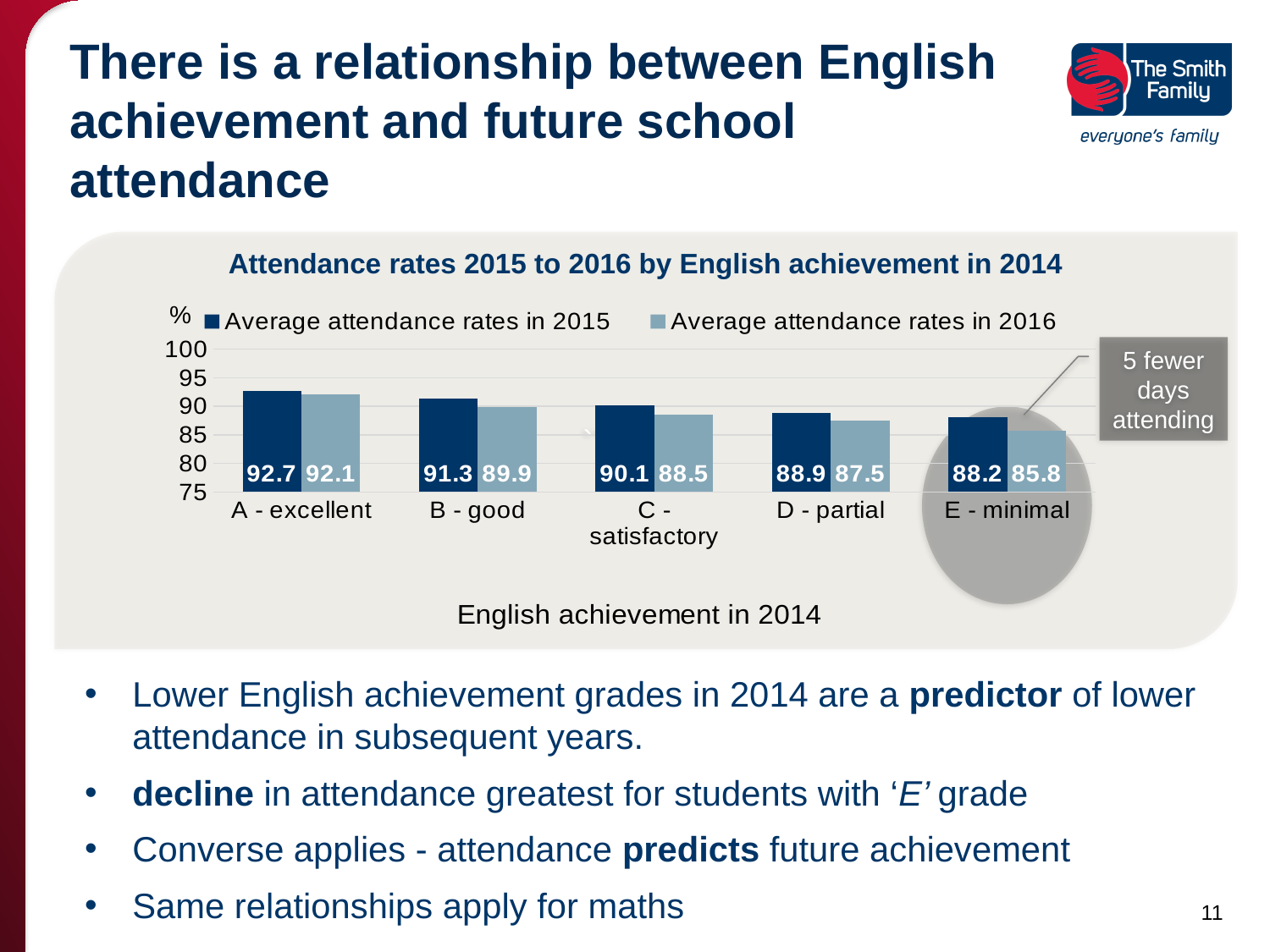
Do the average attendance rates in 2016 rise or fall moving from A - excellent to E - minimal? Fall Which English achievement category has the lowest average attendance rate in 2016? E - minimal What is the difference between the 2015 and 2016 average attendance rates for the E - minimal category? 2.4 What is the average attendance rate in 2016 for students with an E - minimal English grade? 85.8 Which English achievement category has the highest average attendance rate in 2015? A - excellent How many series does the legend list? 2 What is the average attendance rate in 2015 for students with an A - excellent English grade? 92.7 What kind of chart is shown on the slide? Bar chart What is the average attendance rate in 2016 for the C - satisfactory category? 88.5 Which is larger: the 2015 average attendance rate for D - partial or the 2016 average attendance rate for B - good? 2016 average attendance rate for B - good What is the difference between the 2015 average attendance rates for A - excellent and B - good? 1.4 How many English achievement categories are shown on the x axis? 5